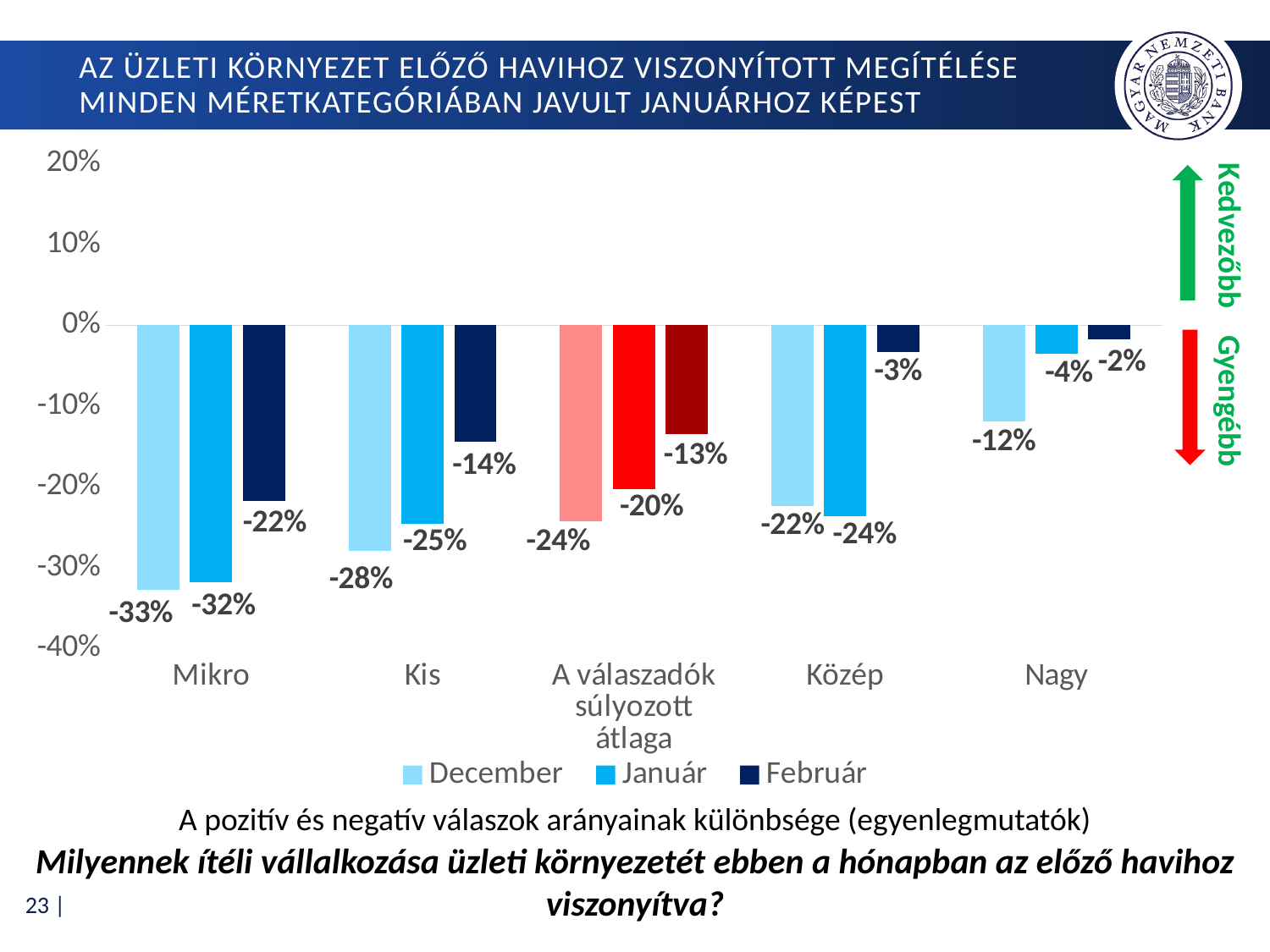
How many categories are shown on the x axis? 5 How many series does the legend list? 3 Which category has the highest Február value? Nagy What is the difference between the Január and Február values for the Kis category? 11 percentage points What type of chart is shown on the slide? Bar chart Which is larger, the December value for Közép or the Január value for Közép? December (-22%) What is the Február value for the Mikro category? -22% What is the Február value for the Nagy category? -2% What is the December value for the Kis category? -28% Which category has the lowest December value? Mikro What is the Január value for 'A válaszadók súlyozott átlaga'? -20% What is the Január value for the Közép category? -24%